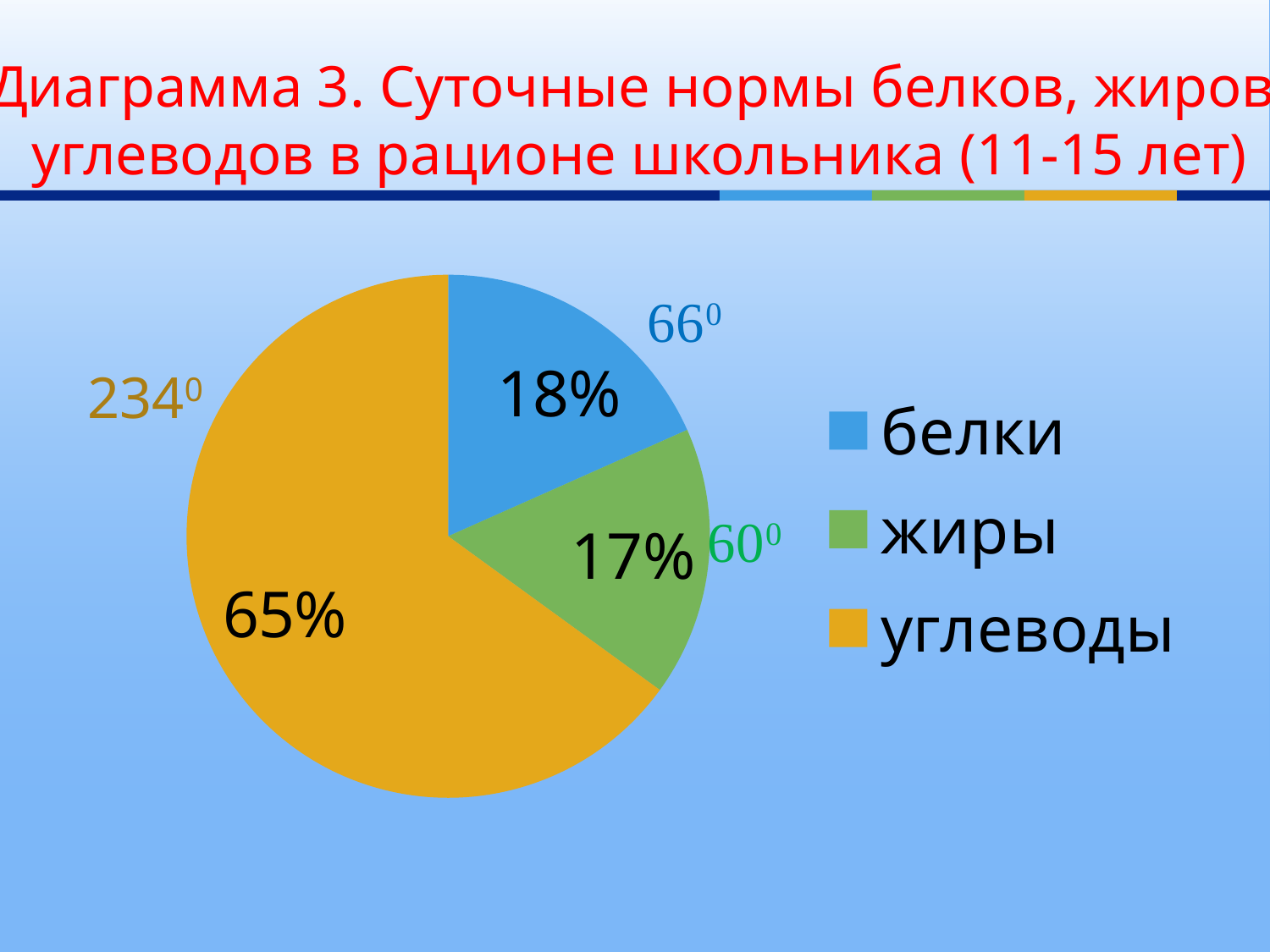
How many slices does the pie chart have? 3 What angle in degrees is labelled for the белки slice? 66⁰ Which category has the largest share of the pie? углеводы What colour is the углеводы slice in the pie chart? yellow/orange What type of chart is shown on the slide? pie chart What angle in degrees is labelled for the углеводы slice? 234⁰ What percentage of the pie is углеводы? 65% Which is larger, the share for белки or the share for жиры? белки What is the difference in percentage points between углеводы and белки? 47% What percentage of the pie is жиры? 17% What percentage of the pie is белки? 18% Which category has the smallest share of the pie? жиры